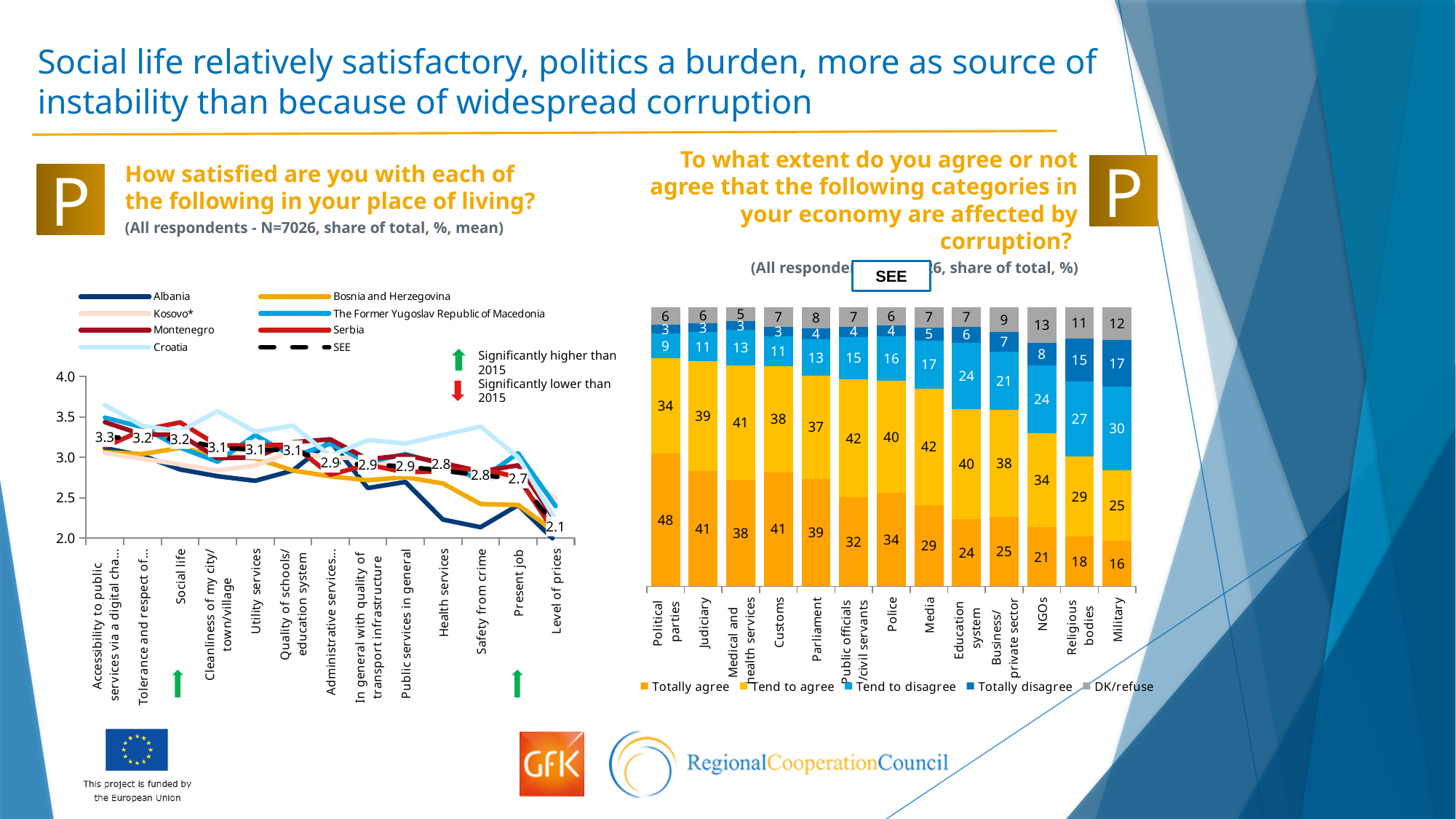
On the right-hand chart about corruption, how many series does the legend list? 5 On the left-hand chart about satisfaction, what kind of chart is used? Line chart On the right-hand chart about corruption, what is the 'DK/refuse' value for NGOs? 13 On the right-hand chart about corruption, how many categories are shown on the x axis? 13 On the right-hand chart about corruption, what is the difference between the 'Tend to disagree' values for Military and Political parties? 21 On the left-hand chart about satisfaction, how many series does the legend list? 8 On the right-hand chart about corruption, which is larger: the 'Totally disagree' value for Religious bodies or for Judiciary? Religious bodies On the left-hand chart about satisfaction, what is the SEE mean value for Level of prices? 2.1 On the right-hand chart about corruption, what share of respondents totally agree that political parties are affected by corruption? 48 On the right-hand chart about corruption, which category has the lowest 'Totally agree' value? Military On the left-hand chart about satisfaction, do the SEE values generally rise or fall from left to right along the x axis? Fall On the right-hand chart about corruption, which category has the highest 'Totally agree' value? Political parties